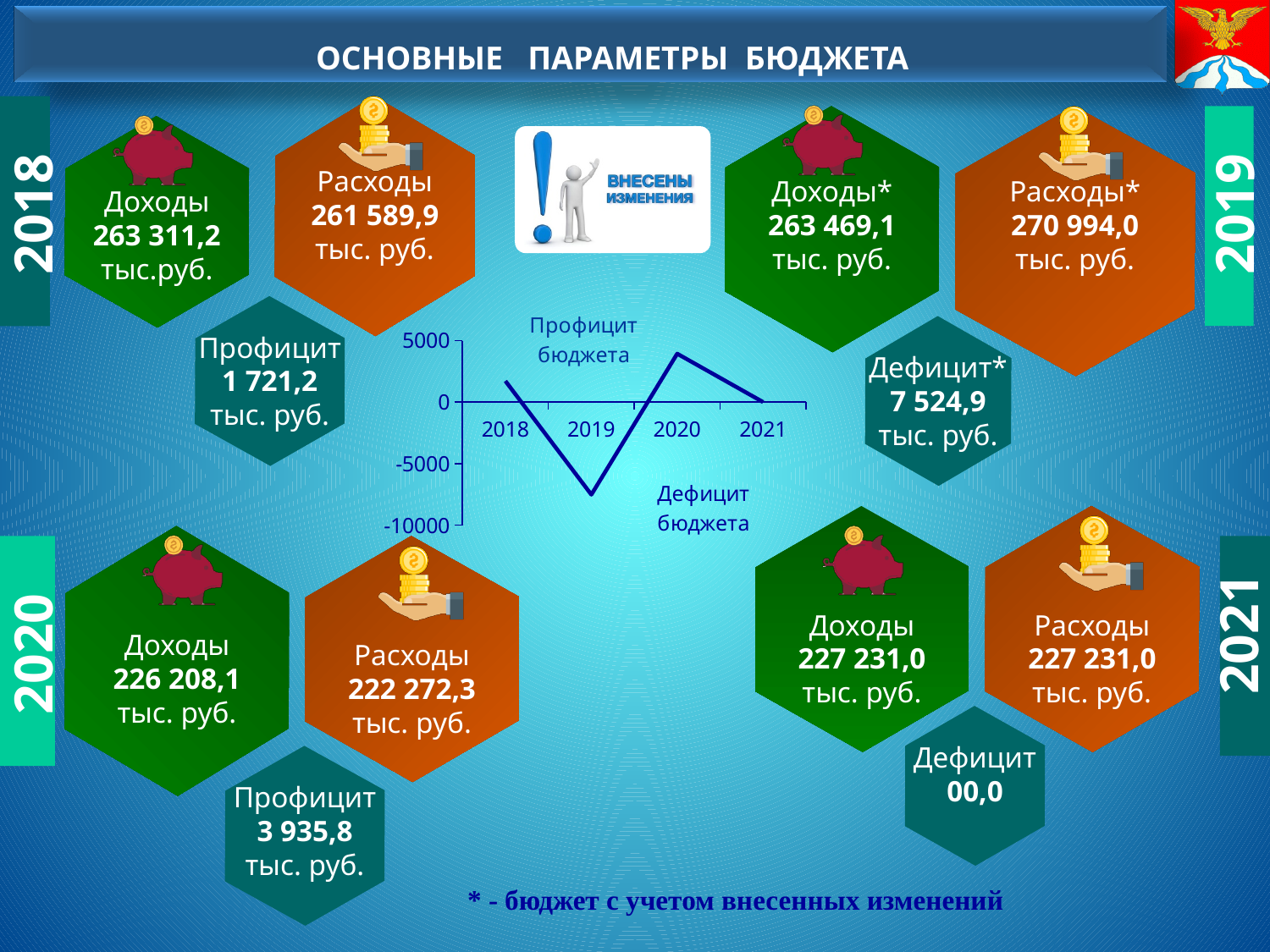
Which year has the lowest point on the line chart? 2019 On the line chart, does the line rise or fall from 2019 to 2020? Rises What label appears above the line chart near the top of the y axis? Профицит бюджета On the line chart, does the line rise or fall from 2018 to 2019? Falls On the line chart, which year has the larger value, 2018 or 2020? 2020 What kind of chart is shown in the centre of the slide? Line chart Which year has the highest point on the line chart? 2020 How many years are plotted on the x axis of the line chart? 4 On the line chart, is the value for 2018 greater or less than 0? greater On the line chart, is the value for 2019 greater or less than -5000? less On the line chart, is the value for 2020 greater or less than 0? greater What are the lowest and highest tick values shown on the y axis of the line chart? -10000 and 5000